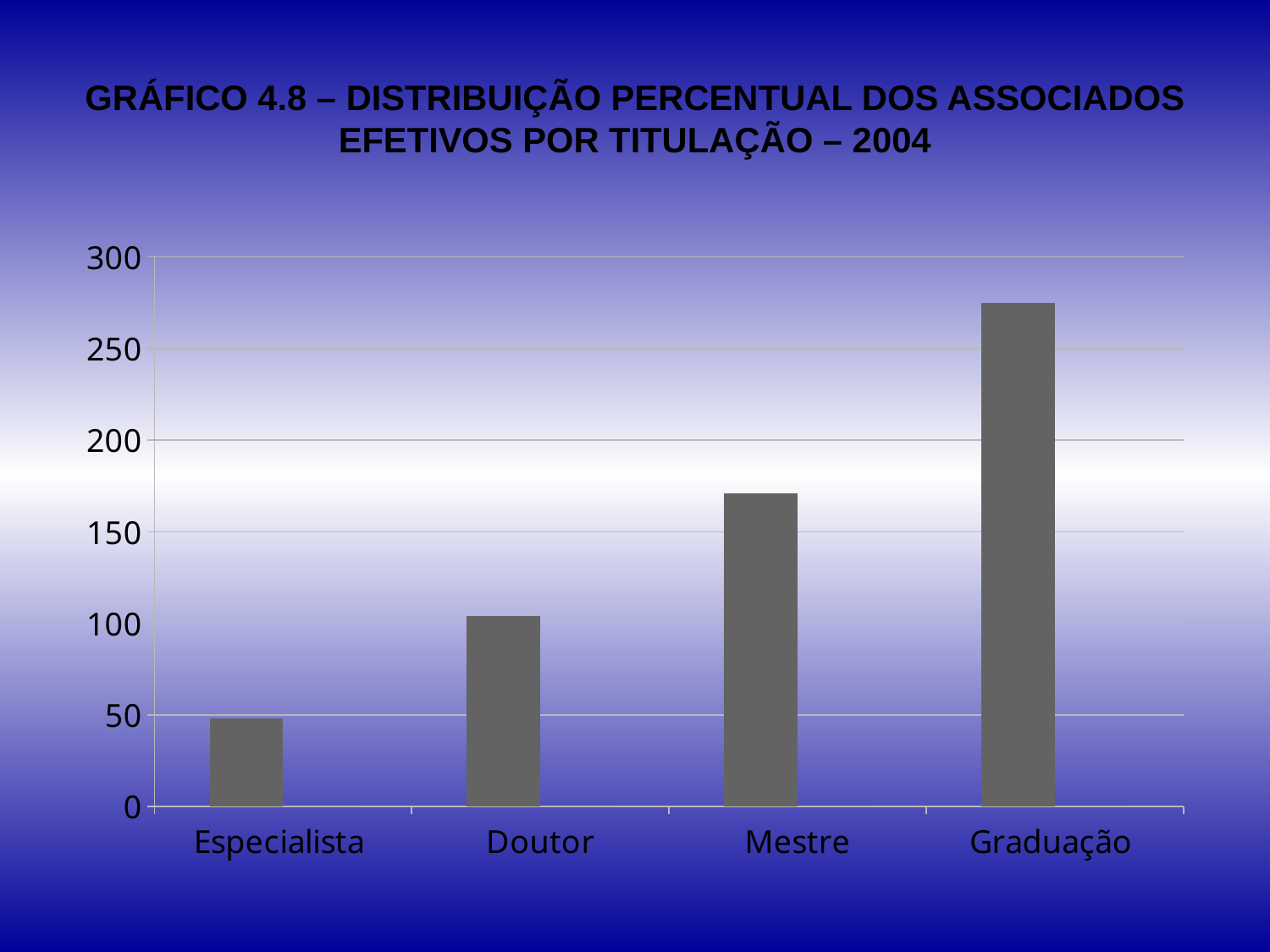
Which category has the highest bar in the chart? Graduação Do the bar values rise or fall from left to right along the x axis? rise What kind of chart is shown on the slide? bar chart What year is mentioned in the chart title? 2004 Which category has the lowest bar in the chart? Especialista Is the value for Mestre greater or less than 200? less Is the value for Mestre greater or less than 150? greater Which is larger, the value for Mestre or the value for Doutor? Mestre How many categories are shown on the x axis of the chart? 4 Is the value for Especialista greater or less than 100? less